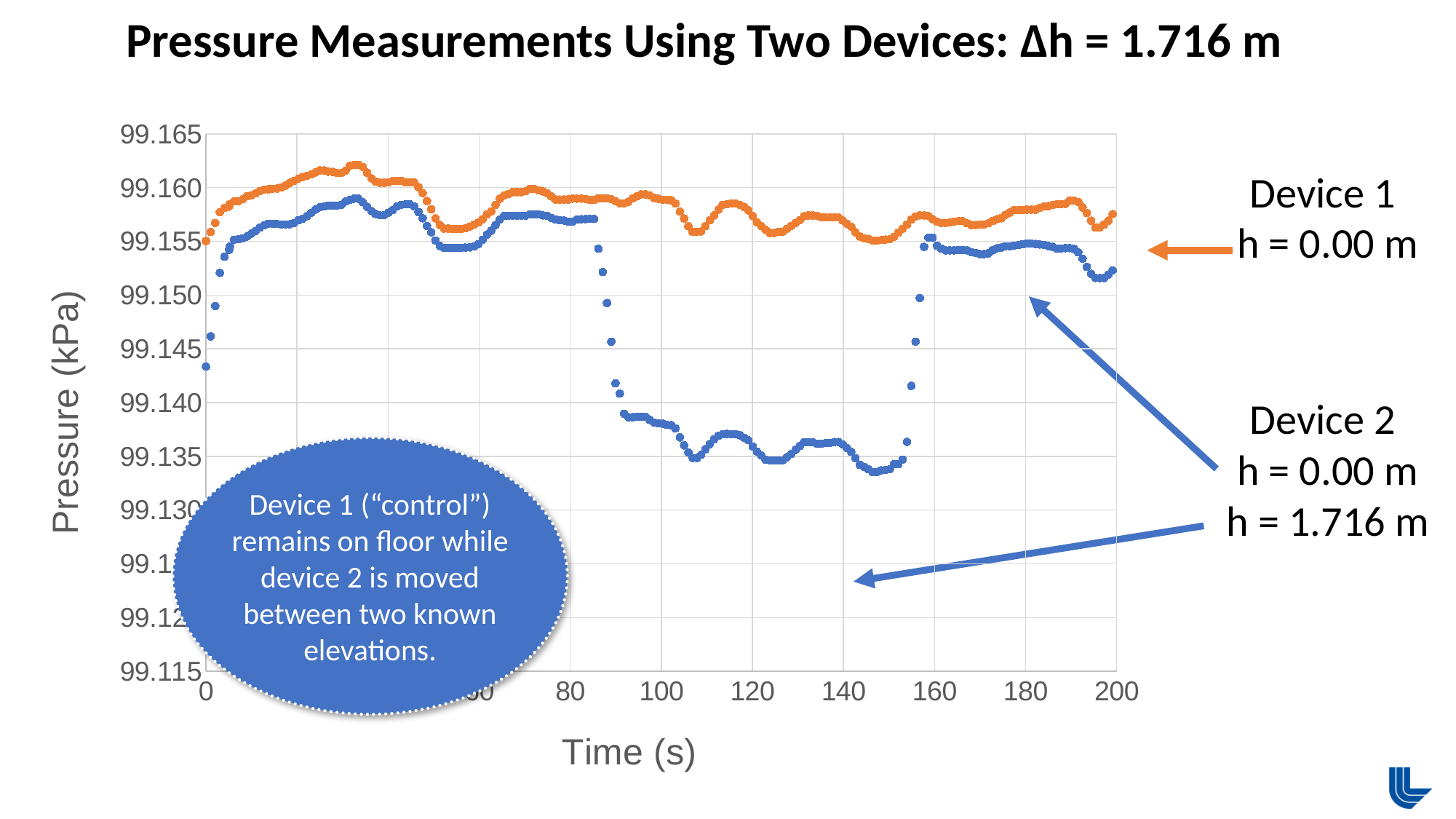
Is the pressure for Device 2 at time 120 s greater or less than 99.145 kPa? less What kind of chart is shown on the slide? Scatter chart Does the pressure for Device 2 rise or fall between 150 s and 160 s? rise How many data series are plotted on the chart? 2 Which device is moved between two known elevations according to the annotation? Device 2 Does the pressure for Device 2 rise or fall between 80 s and 100 s? fall Is the pressure for Device 1 at time 40 s greater or less than 99.155 kPa? greater What is the title of the chart? Pressure Measurements Using Two Devices: Δh = 1.716 m Is the pressure for Device 1 at time 120 s greater or less than 99.155 kPa? greater Which device shows the higher pressure at time 120 s? Device 1 Which series reaches the lowest pressure on the chart? Device 2